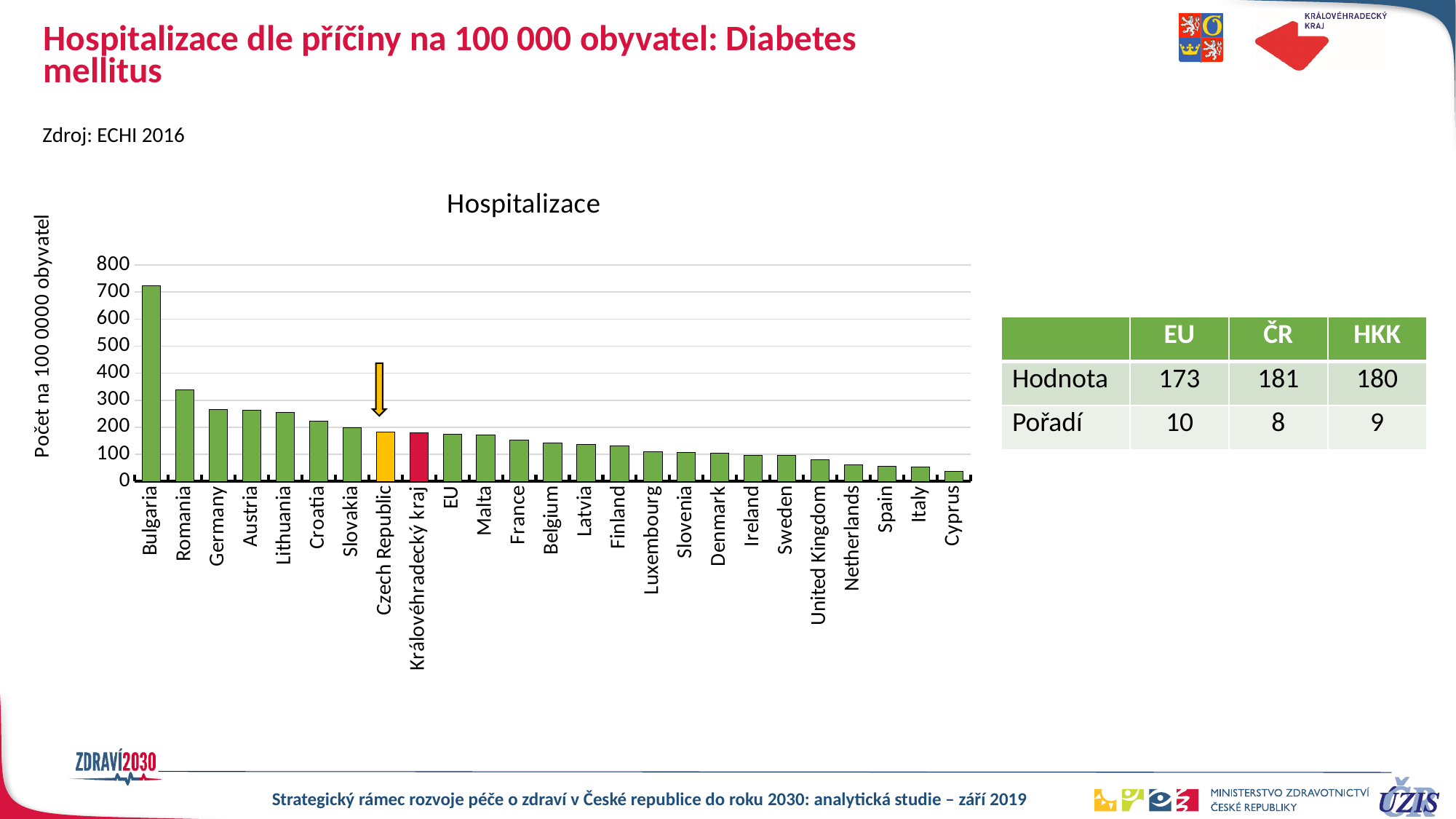
Which category has the highest hospitalization value in the chart? Bulgaria How many categories (bars) are plotted in the chart? 25 Which category has the lowest hospitalization value in the chart? Cyprus Is the value for Bulgaria greater or less than 600? greater According to the table, what is the hospitalization value for Královéhradecký kraj (HKK)? 180 According to the table, what is the hospitalization value for the EU? 173 Is the value for Cyprus greater or less than 100? less Which has a larger value, Bulgaria or Romania? Bulgaria According to the table, what is the hospitalization value for the Czech Republic (ČR)? 181 What type of chart is shown on the slide? bar chart Do the bar values rise or fall from left to right along the x axis? fall What is the difference between the ČR value and the EU value shown in the table? 8